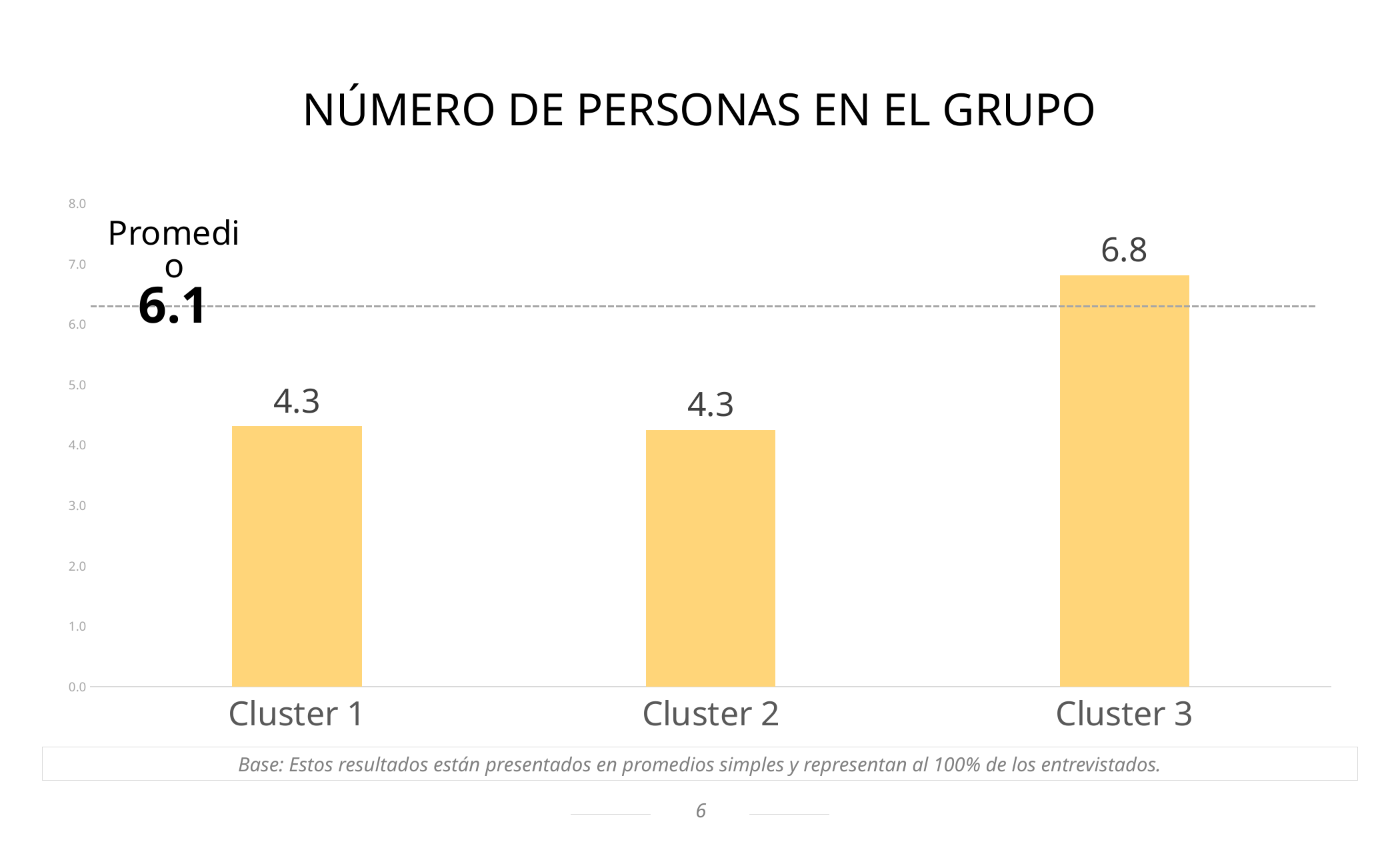
Is the value for Cluster 3 greater or less than 6.0? greater What is the value for Cluster 3? 6.8 What is the average (Promedio) value indicated by the dashed line? 6.1 What is the difference between the values for Cluster 3 and Cluster 1? 2.5 Is the value for Cluster 1 greater or less than 5.0? less What kind of chart is shown on the slide? bar chart How many clusters are shown in the chart? 3 What is the title of the chart? NÚMERO DE PERSONAS EN EL GRUPO Which cluster has the highest value? Cluster 3 Which is larger, the value for Cluster 3 or the value for Cluster 2? Cluster 3 What is the value for Cluster 2? 4.3 What is the value for Cluster 1? 4.3